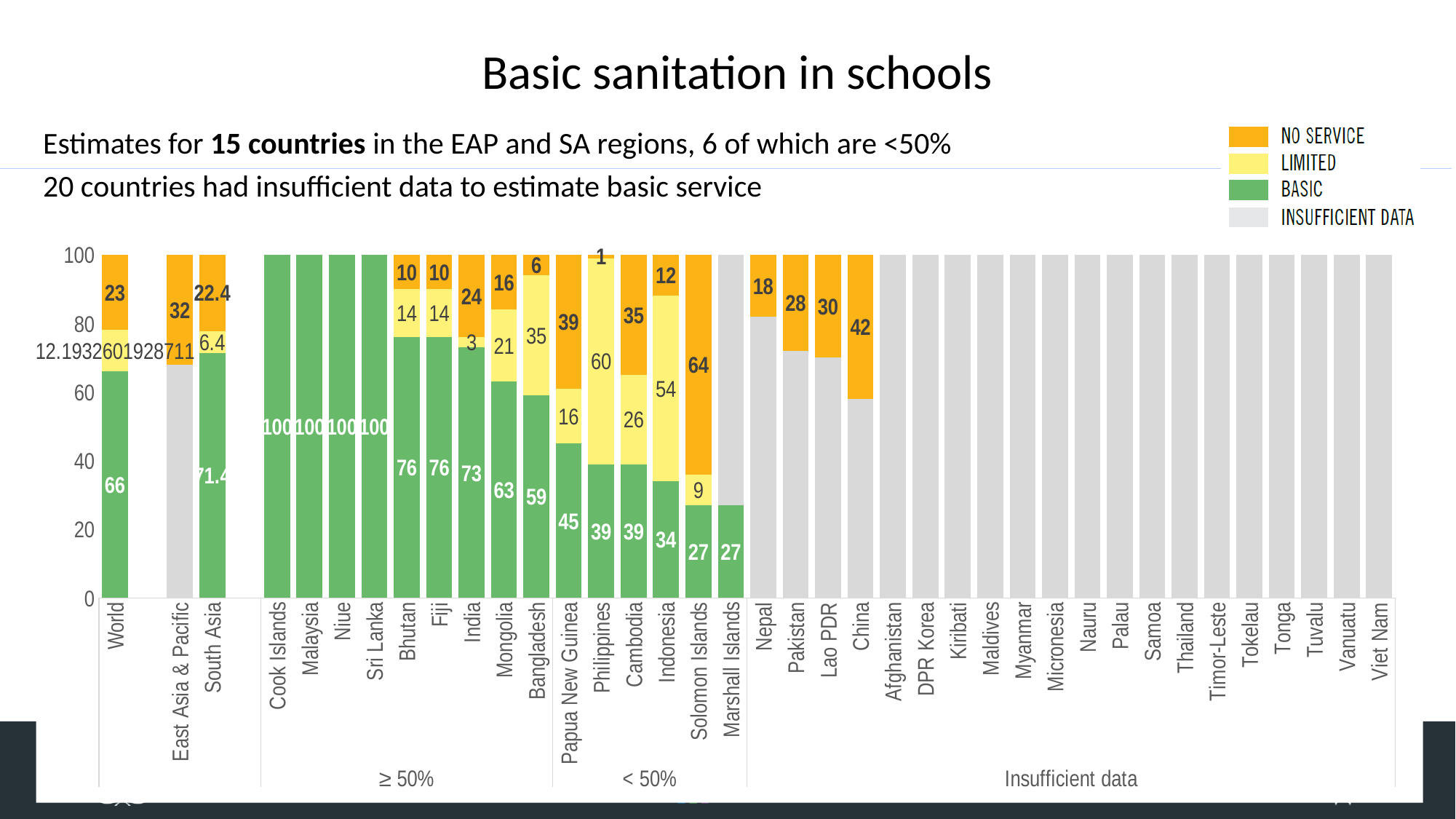
Which has the larger BASIC value, Cambodia or Indonesia? Cambodia What is the BASIC value for Bhutan? 76 What is the LIMITED value for Philippines? 60 What is the NO SERVICE value for Solomon Islands? 64 How many series does the legend list? 4 Which country has the highest NO SERVICE value? Solomon Islands How many countries have a BASIC value of 100? 4 What is the difference between the BASIC values for Mongolia and Bangladesh? 4 What is the total of the stacked bar for Bhutan? 100 What is the BASIC value for World? 66 What kind of chart is shown on the slide? stacked bar chart What is the NO SERVICE value for China? 42